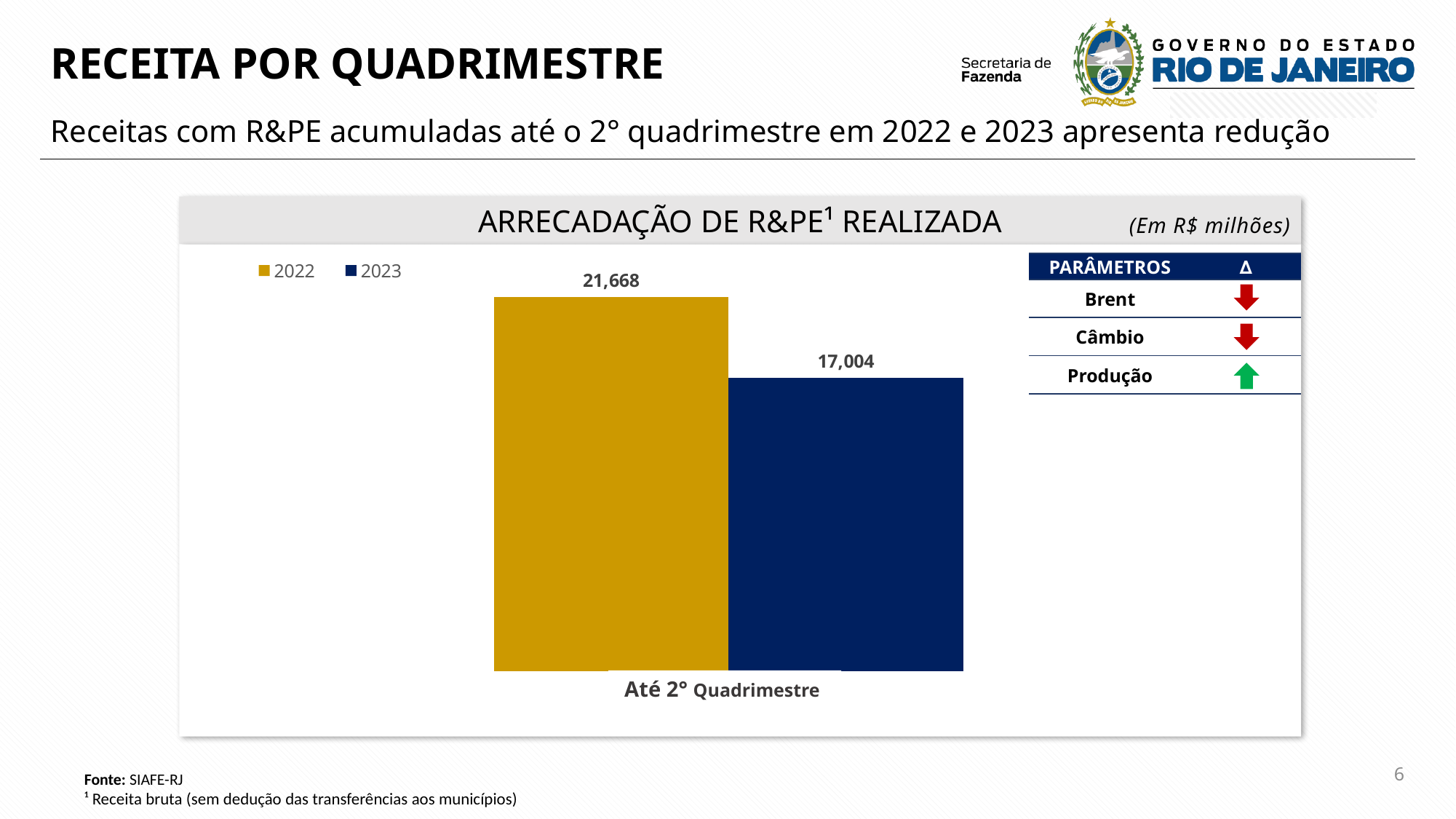
What is the value for 2022 in the chart? 21,668 What is the title of the chart? ARRECADAÇÃO DE R&PE¹ REALIZADA How many categories are shown on the x axis? 1 Which series has the higher value, 2022 or 2023? 2022 What is the label of the category on the x axis? Até 2° Quadrimestre What is the value for 2023 in the chart? 17,004 How many series does the legend list? 2 Does the value fall or rise from 2022 to 2023? Fall What kind of chart is shown on the slide? Bar chart What is the difference between the 2022 and 2023 values? 4,664 Which series has the lowest value in the chart? 2023